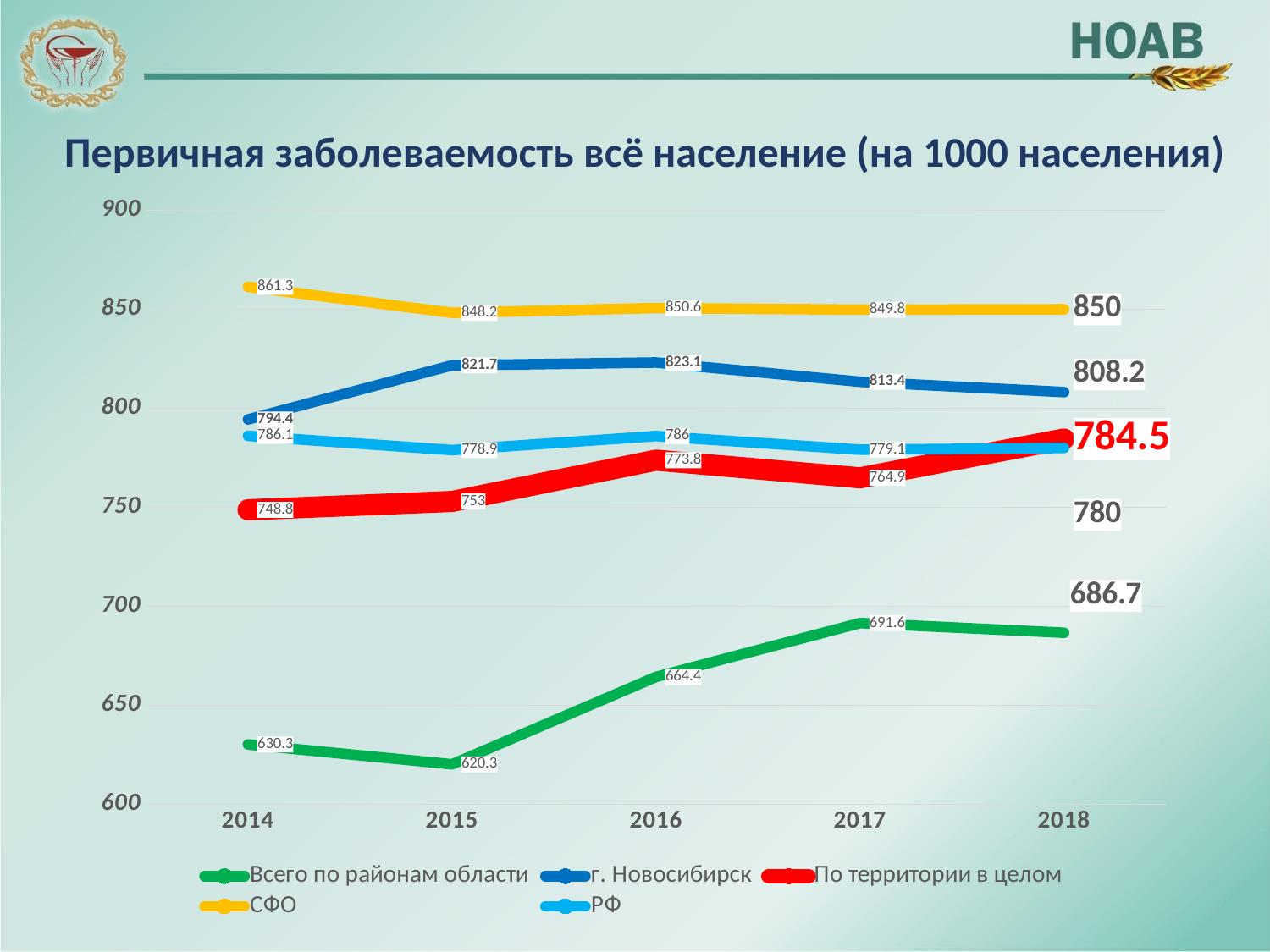
What is the value for По территории в целом in 2018? 784.5 What is the value for Всего по районам области in 2015? 620.3 Which series has the higher value in 2017: РФ or По территории в целом? РФ What is the value for г. Новосибирск in 2016? 823.1 In which year is the value for Всего по районам области the lowest? 2015 What type of chart is shown on the slide? line chart How many years are shown on the x axis? 5 Does the value for Всего по районам области rise or fall from 2015 to 2017? rise In which year is the value for СФО the highest? 2014 What is the difference between the г. Новосибирск value in 2015 and in 2014? 27.3 What is the value for СФО in 2014? 861.3 How many series does the legend list? 5